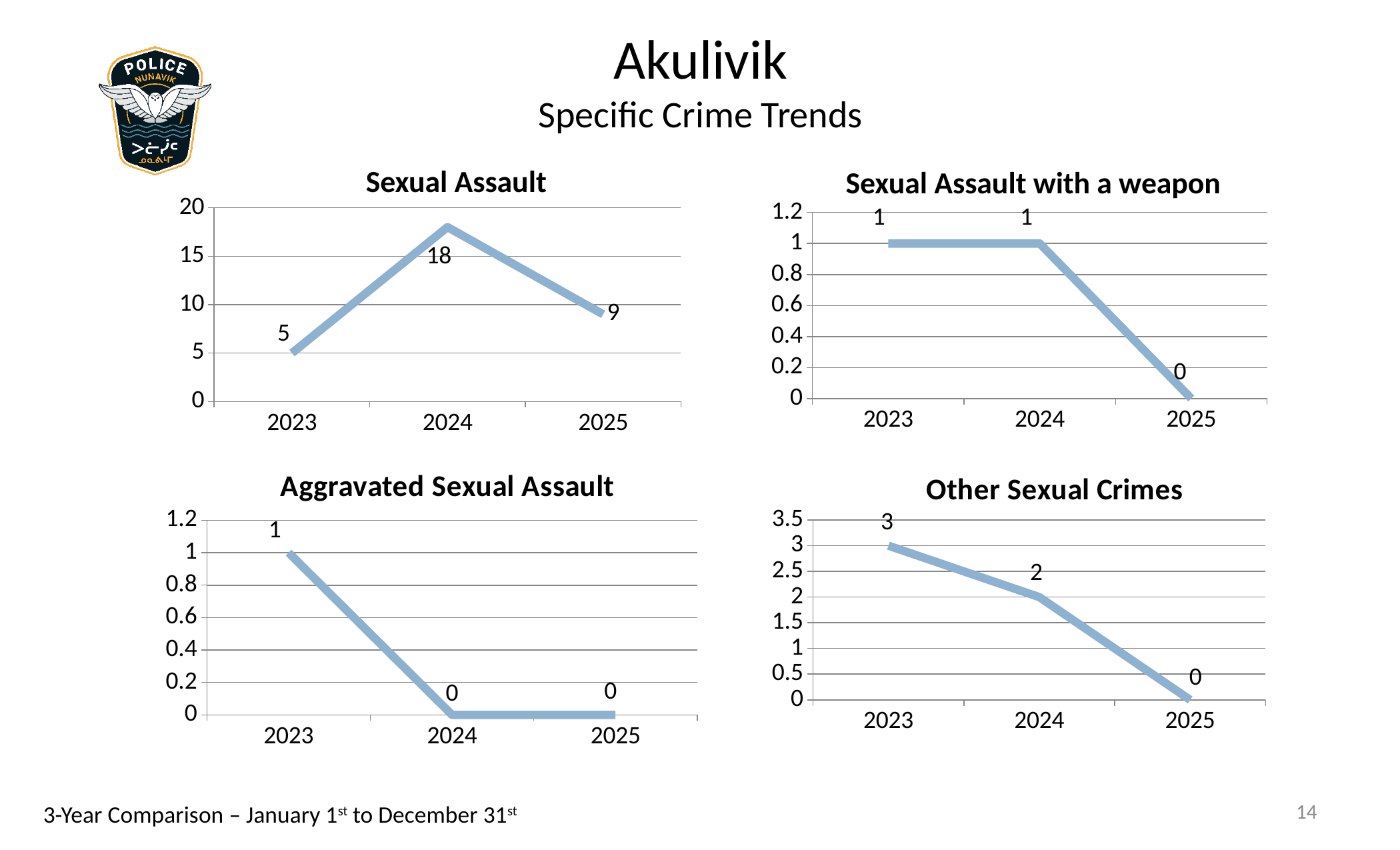
In the Other Sexual Crimes chart, what is the value for 2024? 2 In the Aggravated Sexual Assault chart, do the values rise or fall from 2023 to 2024? fall In the Other Sexual Crimes chart, which year has the highest value? 2023 In the Sexual Assault with a weapon chart, what is the value for 2025? 0 In the Other Sexual Crimes chart, what is the difference between the 2023 and 2025 values? 3 What type of chart is the Other Sexual Crimes chart? line chart In the Sexual Assault chart, is the value for 2023 larger or smaller than the value for 2025? smaller In the Aggravated Sexual Assault chart, what is the value for 2023? 1 In the Sexual Assault chart, which year has the lowest value? 2023 In the Sexual Assault chart, what is the difference between the 2024 and 2025 values? 9 In the Sexual Assault with a weapon chart, how many years are plotted? 3 In the Sexual Assault chart, what is the value for 2024? 18